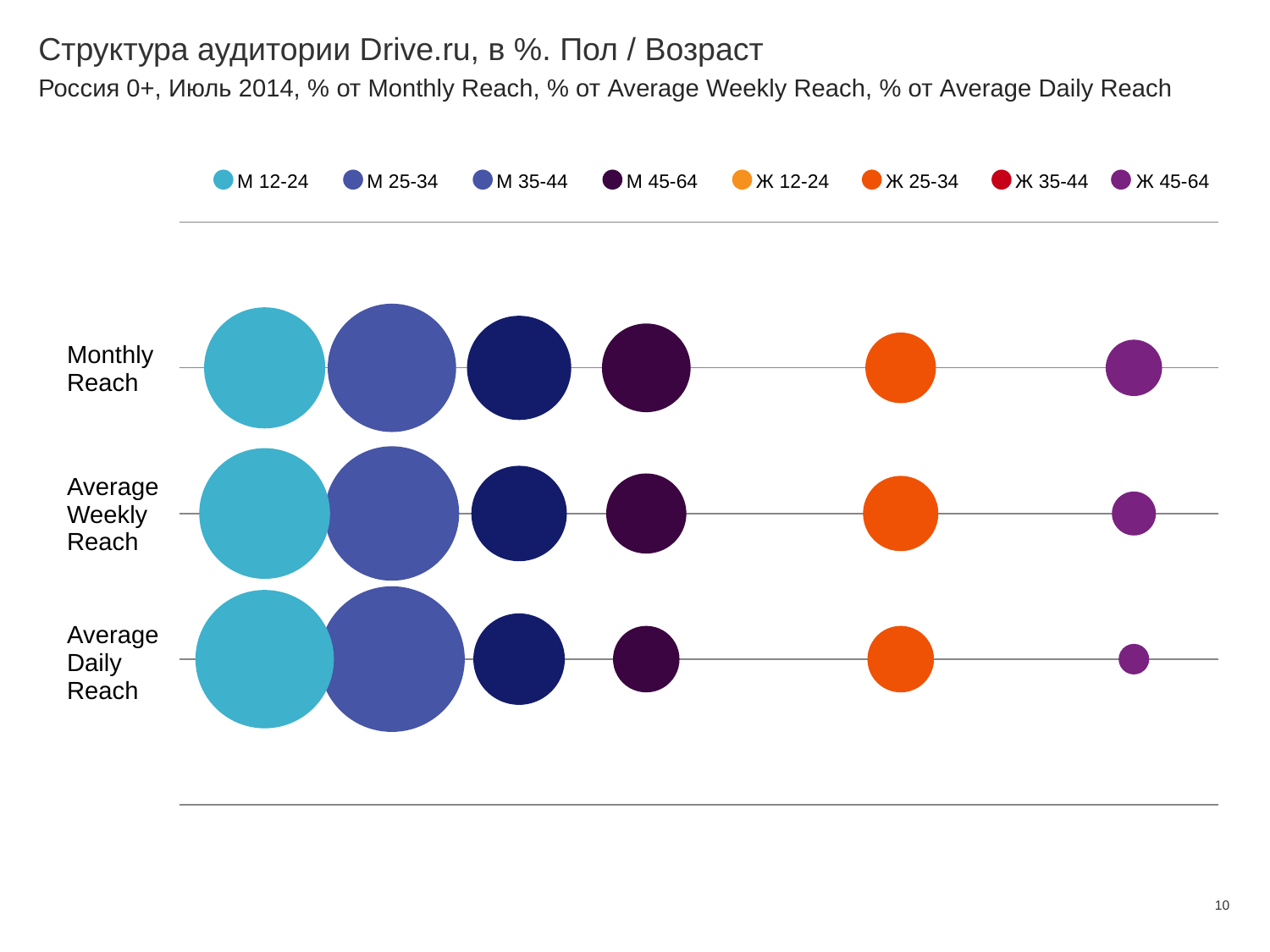
Which series has the smallest bubble in the Average Daily Reach row? Ж 45-64 Which series has the smallest bubble in the Monthly Reach row? Ж 45-64 What kind of chart is shown on the slide? Bubble chart In the Average Weekly Reach row, which bubble is larger: М 35-44 or Ж 45-64? М 35-44 What is the title of the chart on the slide? Структура аудитории Drive.ru, в %. Пол / Возраст In the Monthly Reach row, which bubble is larger: М 12-24 or Ж 25-34? М 12-24 Does the Ж 45-64 bubble get larger or smaller going from Monthly Reach to Average Daily Reach? Smaller Does the М 12-24 bubble get larger or smaller going from Monthly Reach to Average Daily Reach? Larger How many series does the legend list? 8 In the Average Daily Reach row, which bubble is larger: М 45-64 or Ж 45-64? М 45-64 Which two legend series have no visible bubbles plotted on the chart? Ж 12-24 and Ж 35-44 How many reach categories (rows) are plotted on the chart? 3